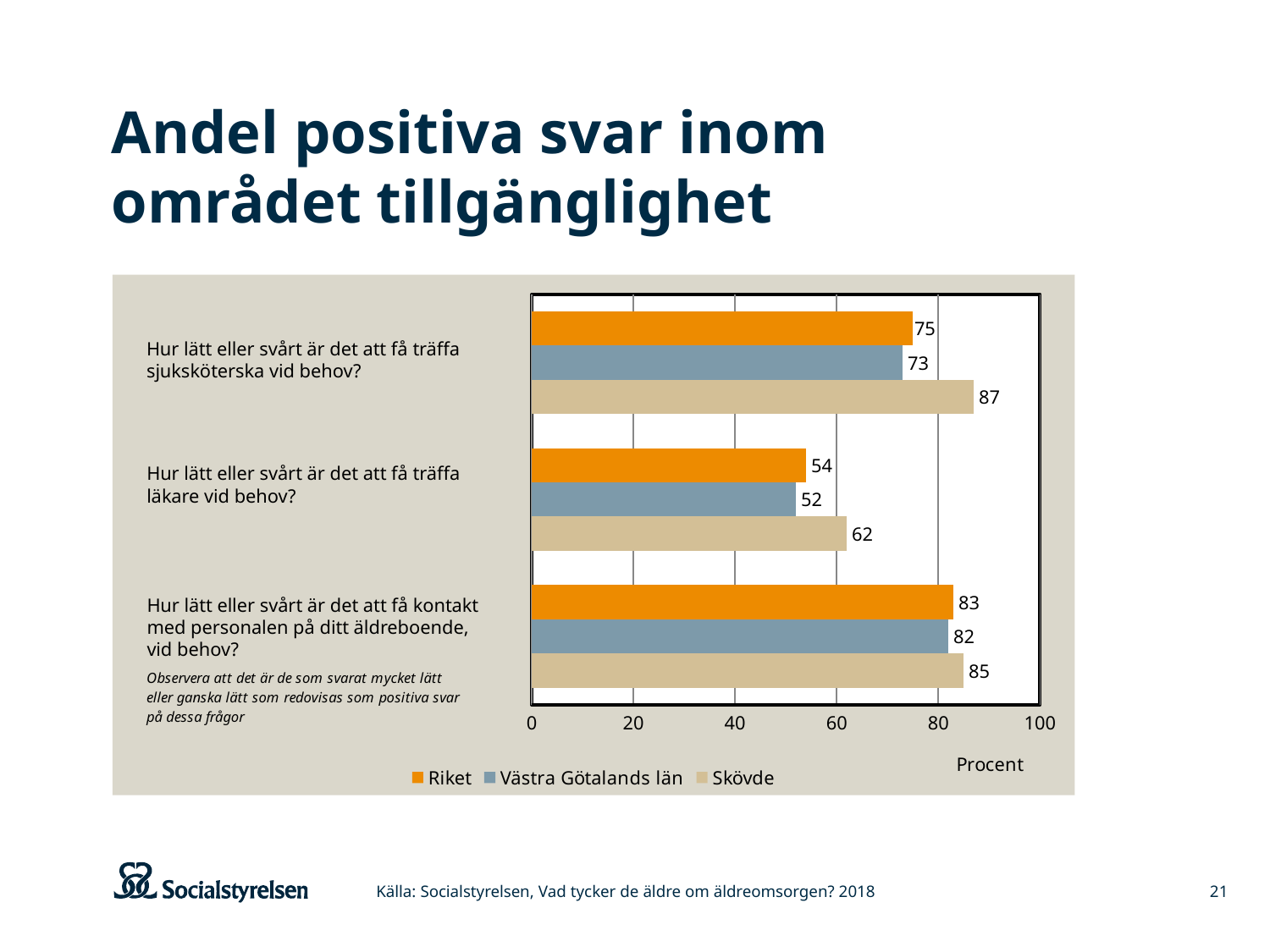
Which series has the highest value on the question about meeting a doctor when needed? Skövde How many series does the legend list? 3 Which series has the lowest value on the question about meeting a nurse when needed? Västra Götalands län What is the value for Riket on the question about meeting a doctor when needed ("Hur lätt eller svårt är det att få träffa läkare vid behov?")? 54 What is the value for Skövde on the question about meeting a nurse when needed ("Hur lätt eller svårt är det att få träffa sjuksköterska vid behov?")? 87 Which is larger on the question about meeting a doctor when needed: the value for Riket or the value for Skövde? Skövde How many questions (categories) are shown in the chart? 3 Is the value for Västra Götalands län on the question about meeting a doctor when needed greater or less than 60? less What is the difference between the Skövde and Riket values on the question about meeting a nurse when needed? 12 What kind of chart is shown on the slide? bar chart What is the value for Västra Götalands län on the question about contacting staff at the care home ("Hur lätt eller svårt är det att få kontakt med personalen på ditt äldreboende, vid behov?")? 82 What unit is shown on the horizontal axis of the chart? Procent